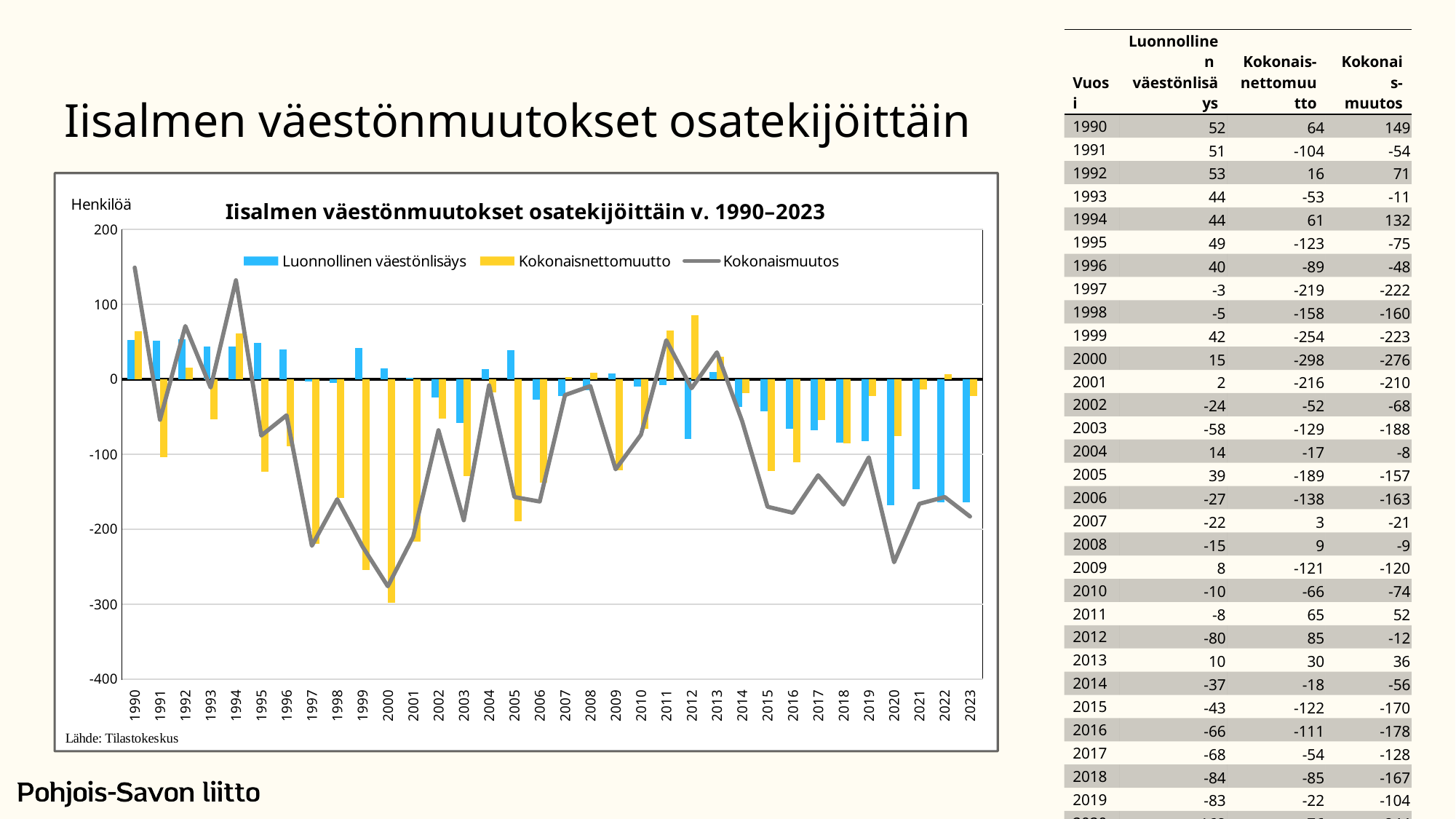
In which year does the Kokonaismuutos line reach its lowest point? 2000 Is the Kokonaisnettomuutto value for 2000 greater or less than -200? less In which year is the Kokonaisnettomuutto bar highest? 2012 Which is larger, the Luonnollinen väestönlisäys value for 1990 or for 2012? 1990 According to the table, what is the Kokonaismuutos value for 1997? -222 Is the Kokonaismuutos value for 1990 greater or less than 100? greater Does the Luonnollinen väestönlisäys series generally rise or fall from 1990 to 2023? fall How many years are shown on the x axis of the chart? 34 What is the title of the chart? Iisalmen väestönmuutokset osatekijöittäin v. 1990–2023 How many series does the chart legend list? 3 In which year is the Kokonaisnettomuutto bar lowest? 2000 What kind of chart is shown on the slide? A bar chart combined with a line